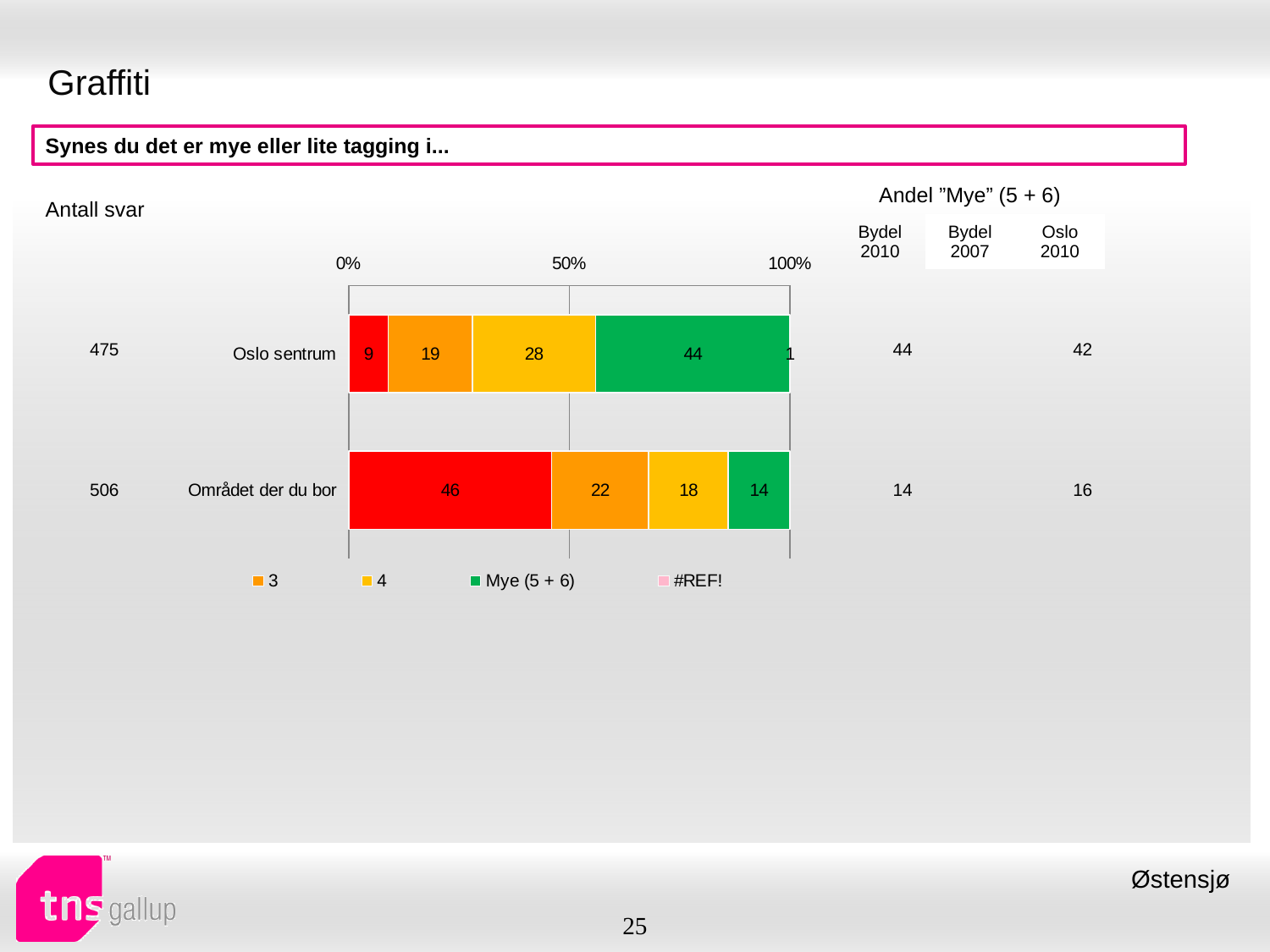
What kind of chart is shown on the slide? Stacked bar chart What question is shown in the box above the chart? Synes du det er mye eller lite tagging i... How many entries does the chart legend list? 4 What is the total of the stacked bar for Området der du bor? 100 What is the difference between the Mye (5 + 6) values for Oslo sentrum and Området der du bor? 30 What is the value of the '4' segment for Området der du bor? 18 What is the difference between the '4' segment values for Oslo sentrum and Området der du bor? 10 What is the value of the Mye (5 + 6) segment for Området der du bor? 14 Which category has the larger Mye (5 + 6) value, Oslo sentrum or Området der du bor? Oslo sentrum What is the value of the Mye (5 + 6) segment for Oslo sentrum? 44 How many categories are plotted on the bar chart? 2 What is the value of the '3' segment for Oslo sentrum? 19